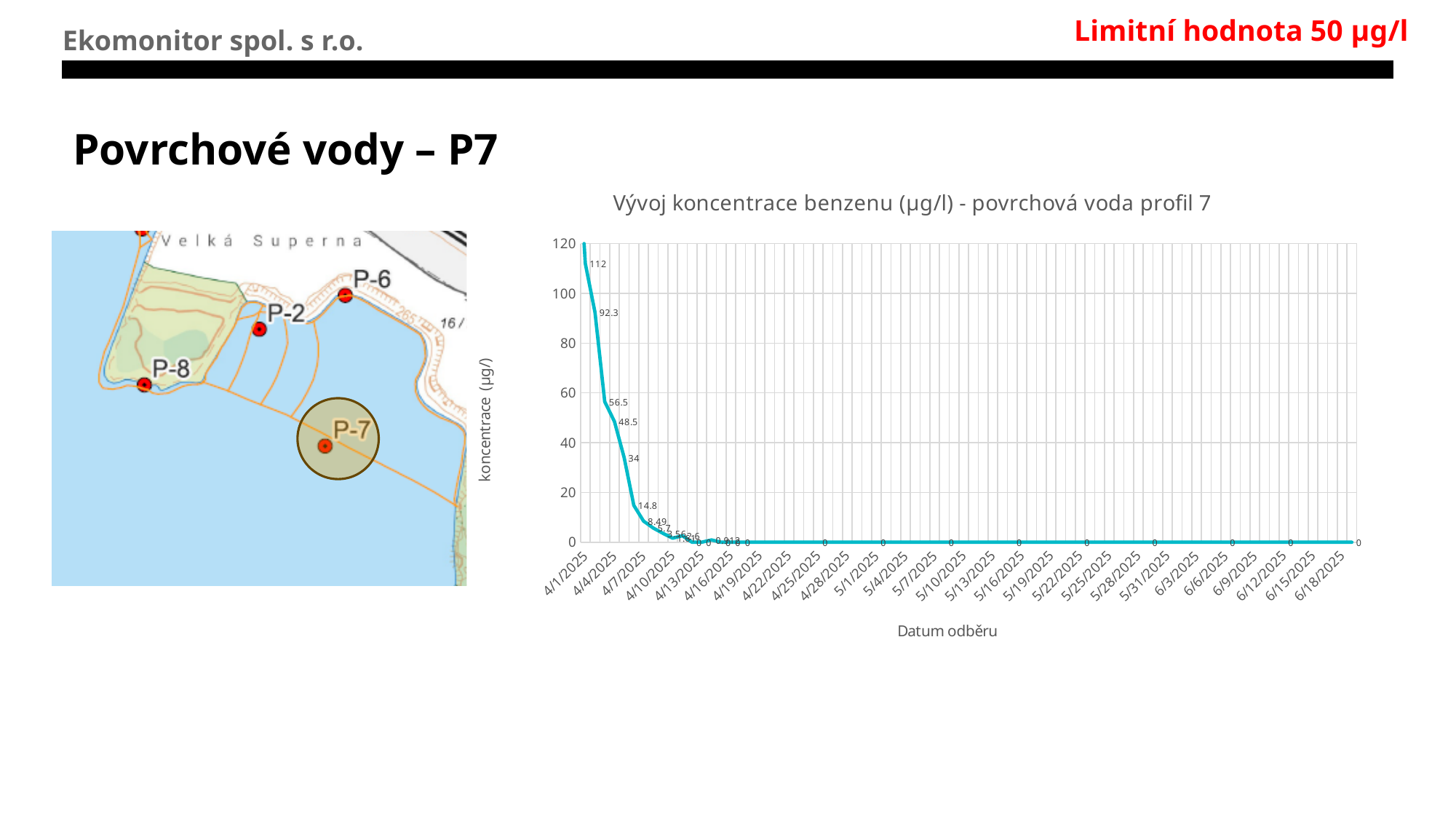
What is the value for 5/1/2025? 0 Is the value for 4/10/2025 greater or less than 20? less What kind of chart is shown on the slide? line chart What is the value for 6/18/2025? 0 Do the values in the chart rise or fall along the x axis? fall Is the value for 4/1/2025 greater or less than 100? greater What is the title of the chart? Vývoj koncentrace benzenu (µg/l) - povrchová voda profil 7 Which is larger, the value for 4/1/2025 or the value for 4/13/2025? 4/1/2025 What is the first date shown on the x axis of the chart? 4/1/2025 Is the value for 4/7/2025 greater or less than 40? less What is the label of the x axis of the chart? Datum odběru What is the value for 5/13/2025? 0